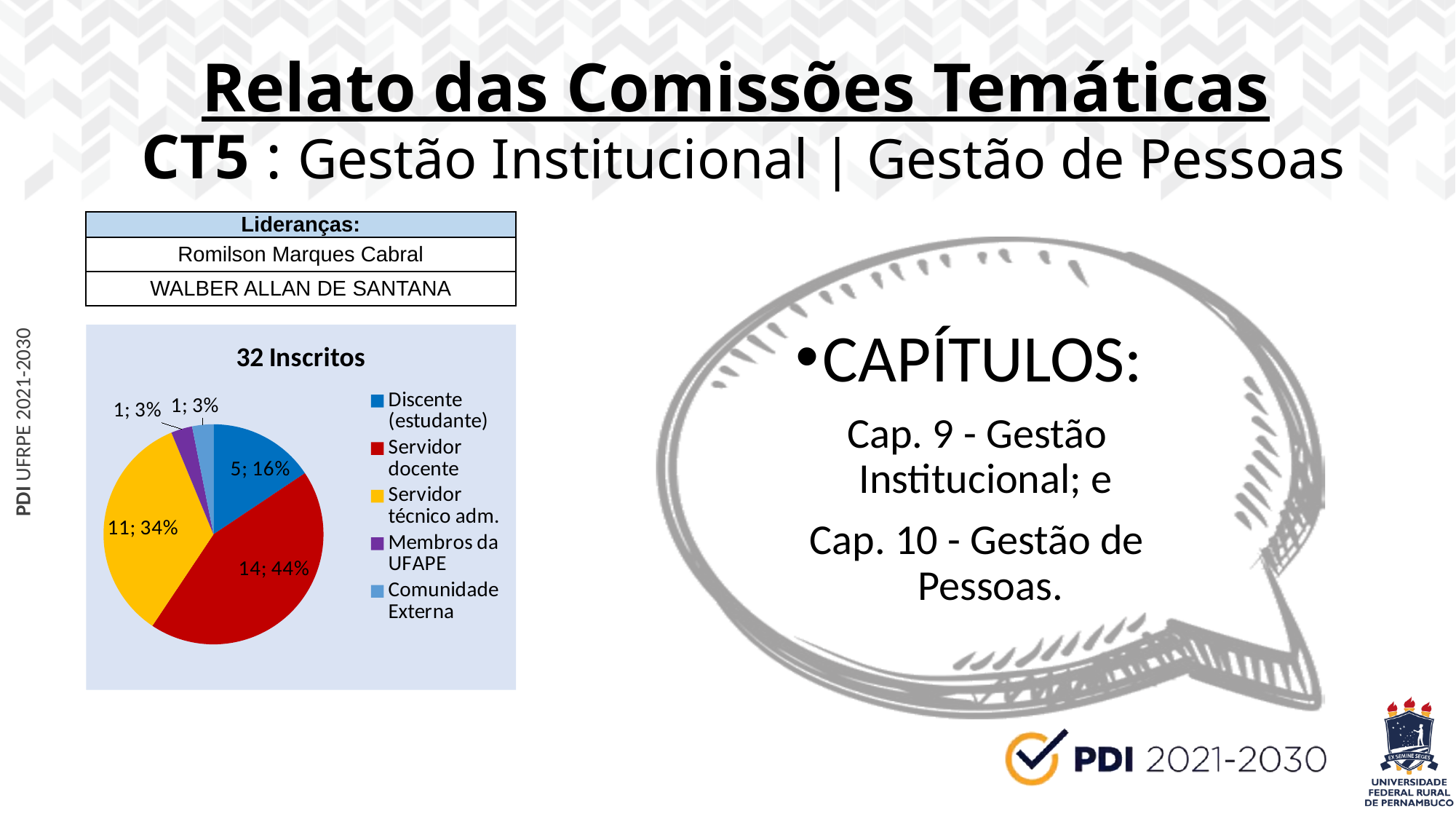
What kind of chart is shown on the slide? pie chart What share of the pie does 'Discente (estudante)' represent? 16% How many inscritos are in the 'Servidor docente' category? 14 Which is larger, the slice for 'Servidor técnico adm.' or the slice for 'Discente (estudante)'? Servidor técnico adm. How many inscritos are in the 'Discente (estudante)' category? 5 How many entries does the legend of the pie chart list? 5 What is the difference in count between 'Servidor docente' and 'Servidor técnico adm.'? 3 How many slices does the pie chart have? 5 What share of the pie does 'Servidor técnico adm.' represent? 34% What is the title of the pie chart? 32 Inscritos What colour is the slice for 'Membros da UFAPE'? purple Which category has the largest slice of the pie? Servidor docente